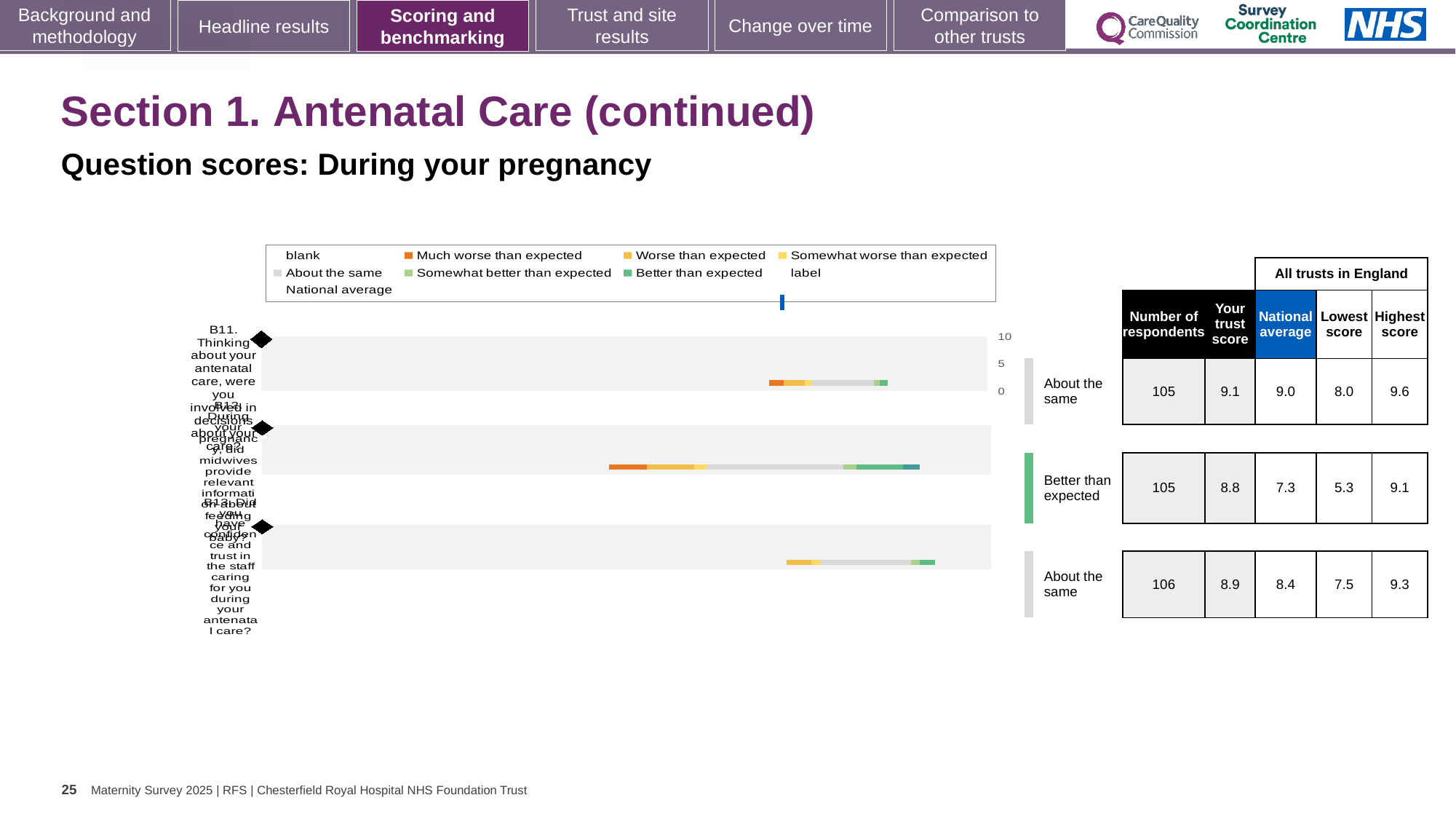
In the table beside the chart, what is the number of respondents for question B11? 105 In the table beside the chart, what is the 'Your trust score' for question B12? 8.8 In the table beside the chart, which question has the lowest 'Lowest score' across all trusts in England? B12 In the table beside the chart, what is the difference between the trust score and the national average for question B11? 0.1 How many entries does the chart legend list? 9 In the chart legend, what colour represents 'Much worse than expected'? Orange In the table beside the chart, what is the national average for question B13? 8.4 What benchmark category is shown next to the bar for question B12? Better than expected In the table beside the chart, which question has the highest 'Your trust score'? B11 What kind of chart is used to show the question scores on this slide? Bar chart How many questions (bars) are plotted in the chart? 3 For question B13, which is larger: the trust score or the national average? The trust score (8.9)